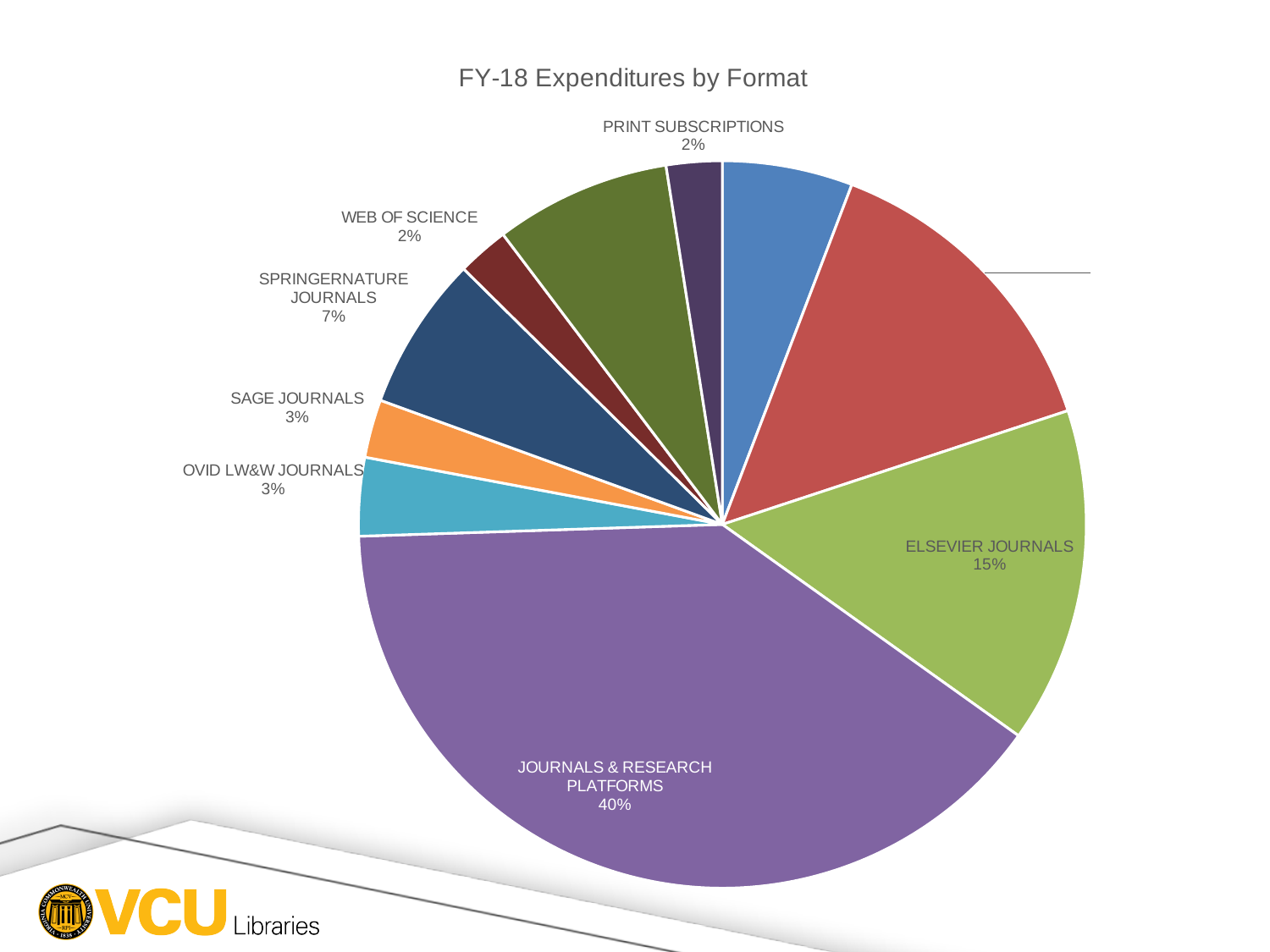
What type of chart is shown on the slide? Pie chart What percentage is shown for Print Subscriptions? 2% How many slices does the pie chart have? 10 Which has a larger share, Elsevier Journals or SpringerNature Journals? Elsevier Journals What percentage is shown for SpringerNature Journals? 7% How many percentage points larger is the Journals & Research Platforms share than the Elsevier Journals share? 25 percentage points What percentage of expenditures is shown for Elsevier Journals? 15% What percentage is shown for Web of Science? 2% Which category has the largest share of FY-18 expenditures? Journals & Research Platforms What is the title of the chart? FY-18 Expenditures by Format What percentage is shown for Ovid LW&W Journals? 3% What share of FY-18 expenditures went to Journals & Research Platforms? 40%